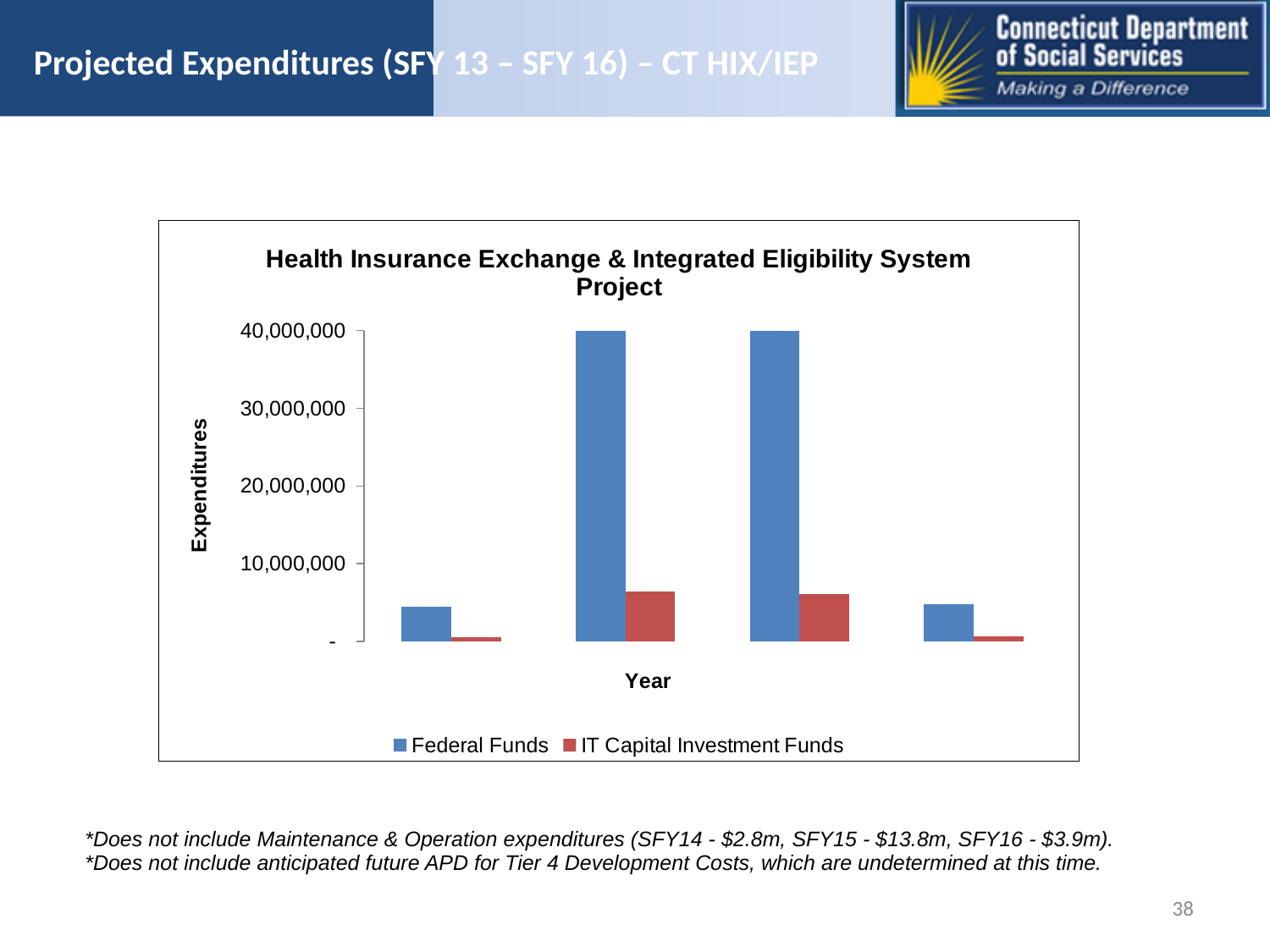
What is the label on the vertical axis? Expenditures Is the Federal Funds value for the second group of bars from the left greater or less than 30,000,000? greater Is the Federal Funds value for the first group of bars from the left greater or less than 10,000,000? less How many groups of bars are plotted along the x axis? 4 What is the title of the chart? Health Insurance Exchange & Integrated Eligibility System Project Which series is shown in blue in the legend? Federal Funds Is the IT Capital Investment Funds value for the third group of bars from the left greater or less than 10,000,000? less In the second group of bars from the left, which series has the larger value, Federal Funds or IT Capital Investment Funds? Federal Funds How many series does the legend list? 2 What kind of chart is shown on the slide? bar chart